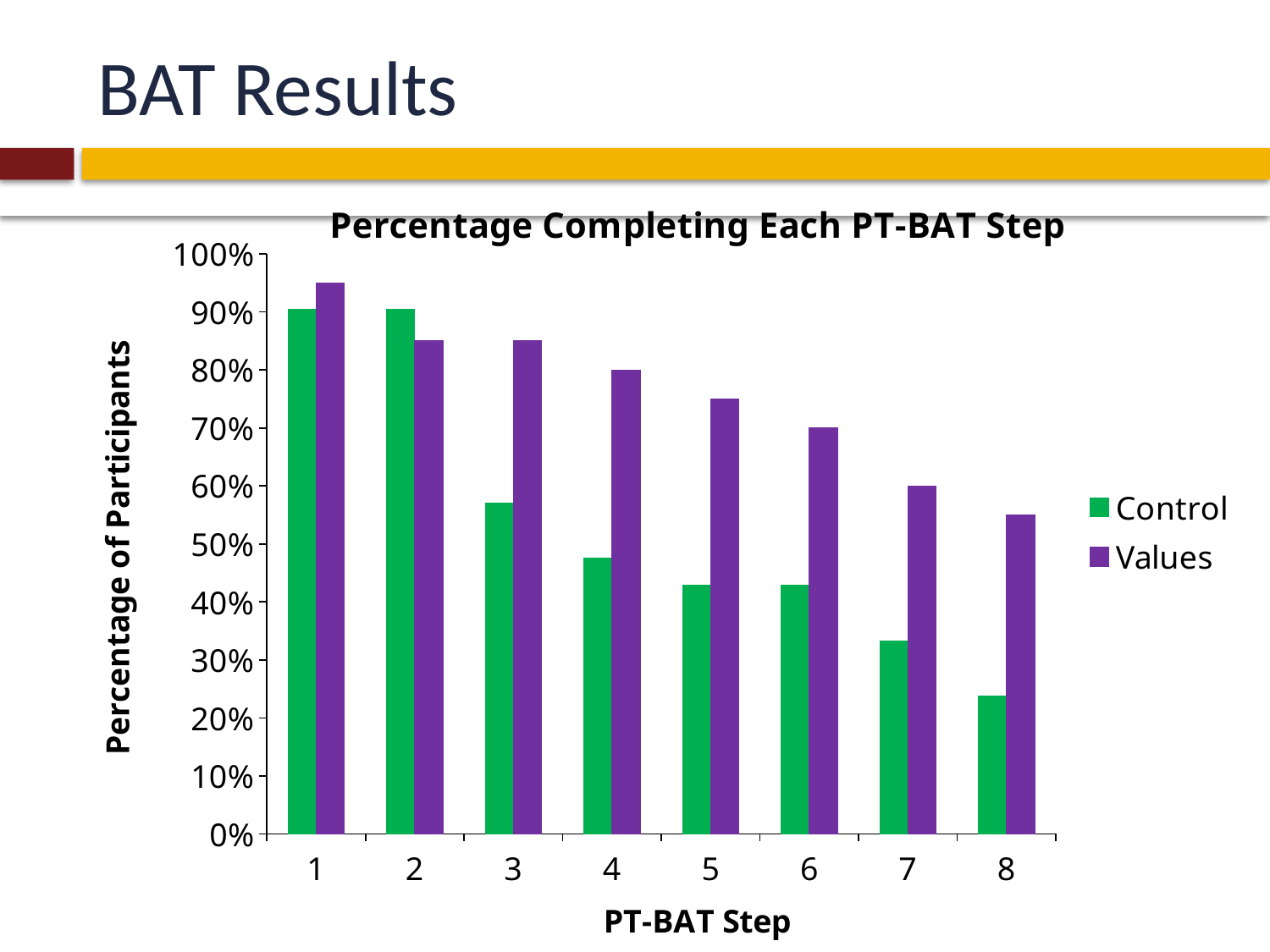
Do the Values series bars generally rise or fall from step 1 to step 8? fall How many series does the legend list? 2 How many PT-BAT steps are shown on the x axis? 8 Is the Control value at step 3 greater or less than 60%? less Is the Values value at step 1 greater or less than 90%? greater What type of chart is shown on the slide? bar chart At which PT-BAT step is the Values series highest? 1 Is the Control value at step 8 greater or less than 30%? less At which PT-BAT step is the Control series lowest? 8 At step 3, which series has the larger value, Control or Values? Values What is the title of the chart? Percentage Completing Each PT-BAT Step Which series is shown in purple? Values